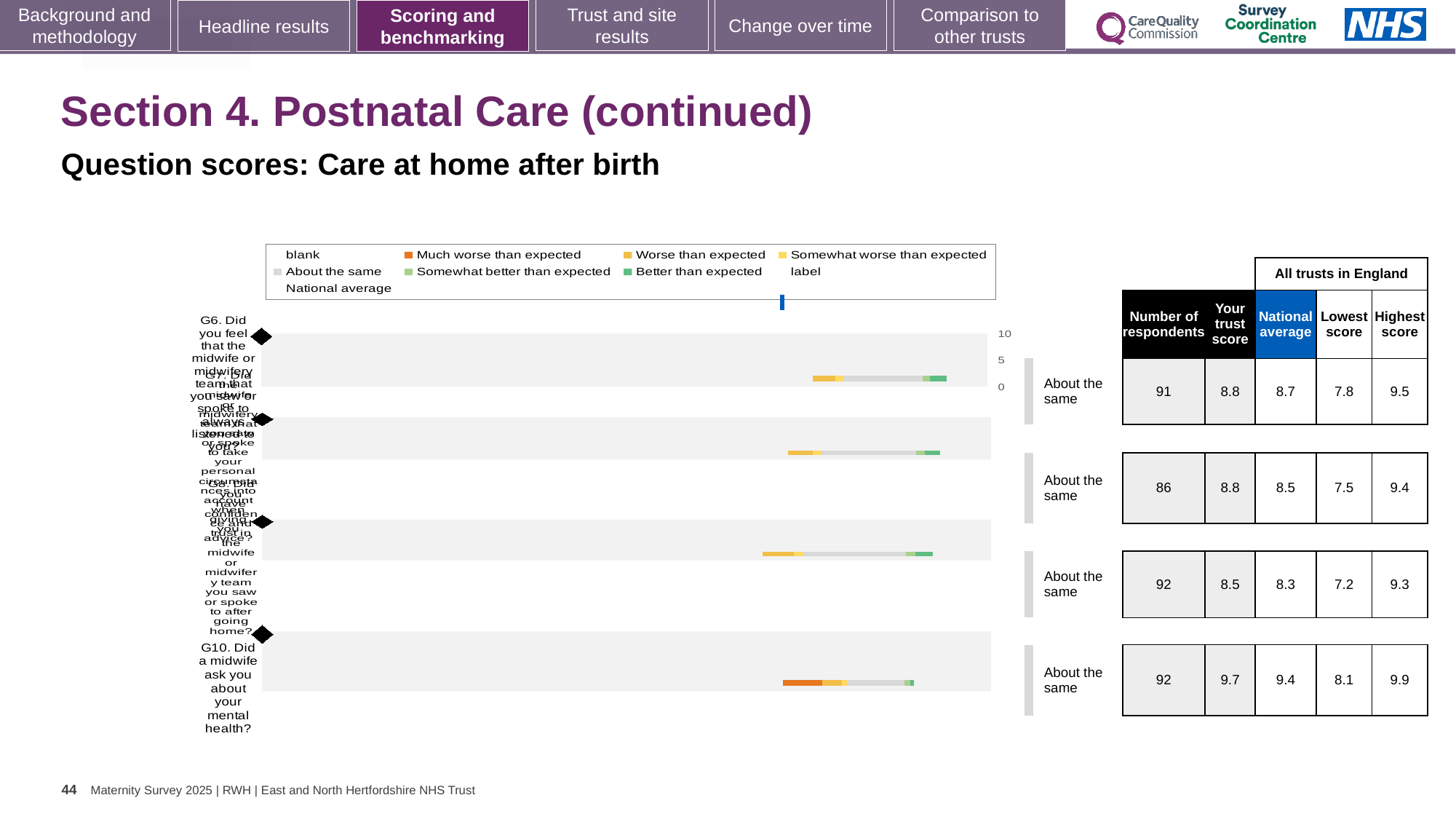
What benchmark category is shown next to the bar for G10 (Did a midwife ask you about your mental health?)? About the same How many entries does the chart legend list? 9 In the table, what is the number of respondents for G10 (Did a midwife ask you about your mental health?)? 92 How many question bars are plotted in the chart? 4 In the table, what is the national average for G10 (Did a midwife ask you about your mental health?)? 9.4 In the table, what is the trust score for G10 (Did a midwife ask you about your mental health?)? 9.7 In the table, what is the highest score across all trusts in England for G10 (Did a midwife ask you about your mental health?)? 9.9 What is the difference between the trust score and the national average for G10? 0.3 What kind of chart is shown on the slide? bar chart In the table, what is the number of respondents for the first row (G6)? 91 Which question row has the highest trust score in the table? G10 For G10, which is larger: the trust score or the national average? the trust score